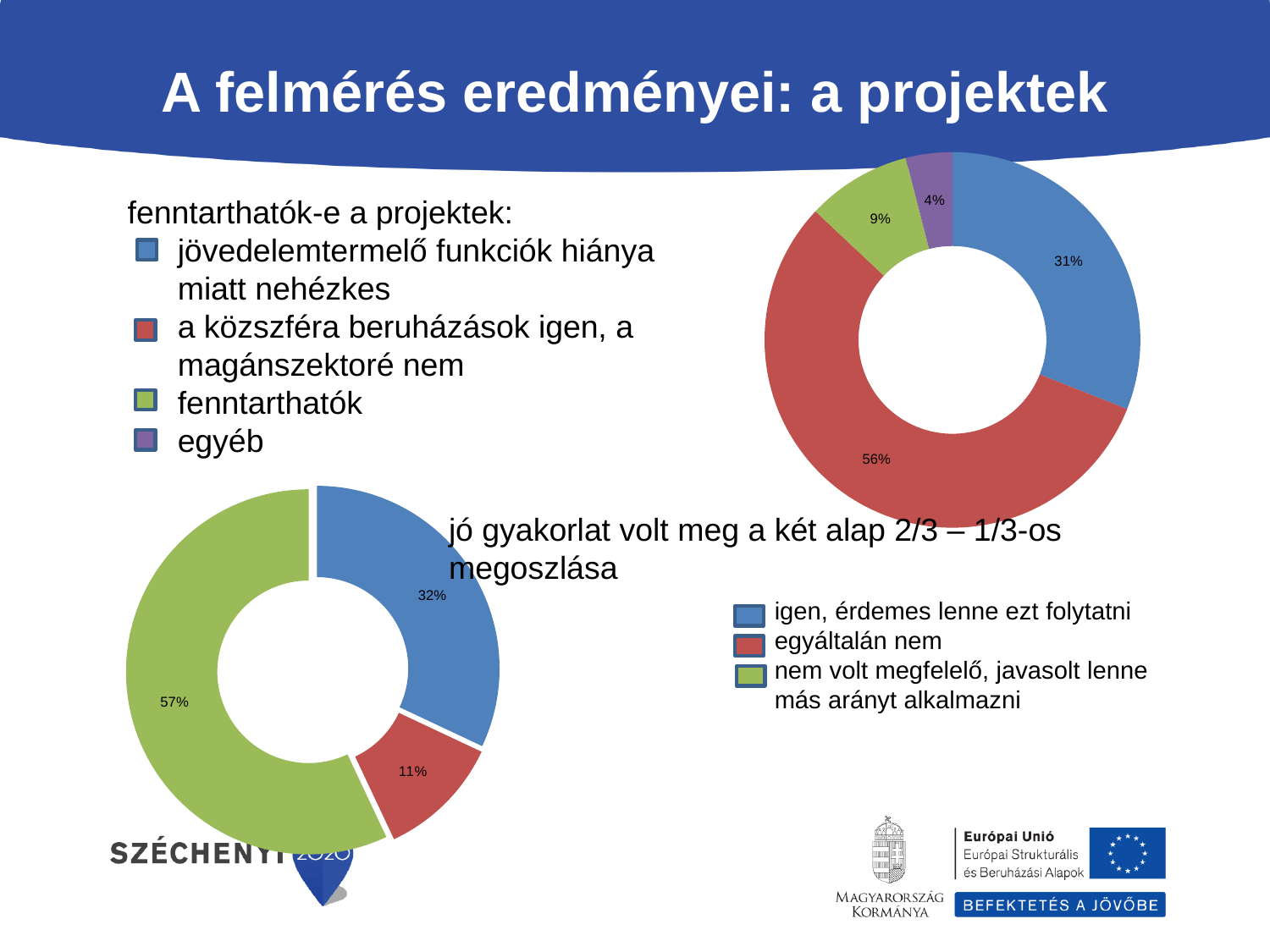
In the bottom-left doughnut chart, what percentage is shown for 'egyáltalán nem'? 11% In the top-right doughnut chart, what percentage is shown for 'egyéb'? 4% In the top-right doughnut chart, which category has the largest share? a közszféra beruházások igen, a magánszektoré nem In the bottom-left doughnut chart, which is larger: the share for 'igen, érdemes lenne ezt folytatni' or for 'egyáltalán nem'? igen, érdemes lenne ezt folytatni What type of chart is used for both charts on the slide? Doughnut (pie) chart In the top-right doughnut chart, which category has the smallest share? egyéb In the bottom-left doughnut chart, which category has the largest share? nem volt megfelelő, javasolt lenne más arányt alkalmazni In the top-right doughnut chart, what is the difference in percentage points between the 56% slice and the 31% slice? 25 In the bottom-left doughnut chart, what percentage is shown for 'igen, érdemes lenne ezt folytatni'? 32% How many slices does the top-right doughnut chart have? 4 In the top-right doughnut chart, what percentage is shown for the red slice 'a közszféra beruházások igen, a magánszektoré nem'? 56% In the top-right doughnut chart, what percentage is shown for 'fenntarthatók'? 9%